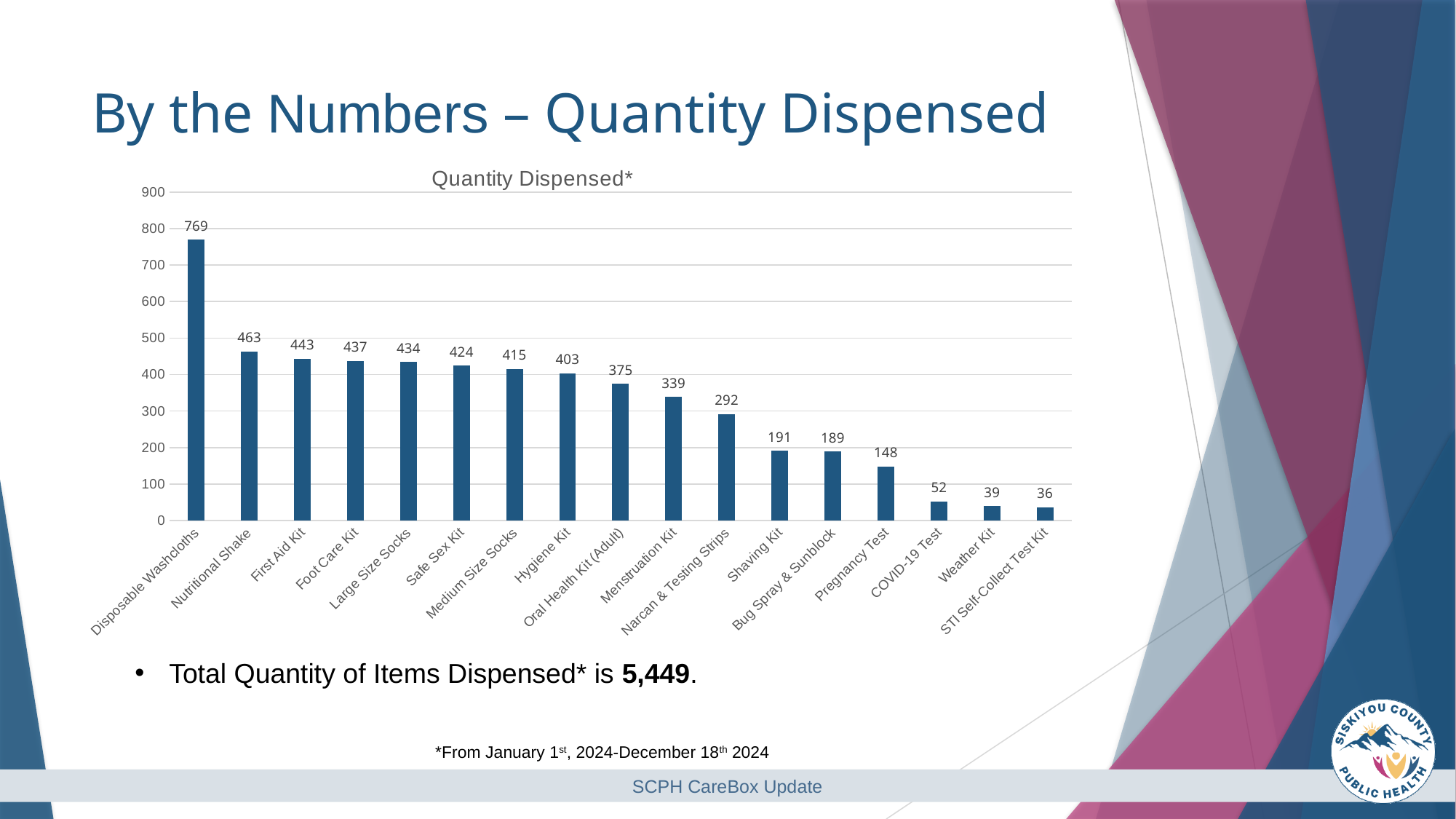
Which category has the lowest quantity dispensed? STI Self-Collect Test Kit What is the value for Pregnancy Test? 148 Do the values rise or fall from left to right along the x axis? Fall Which is larger, the value for Hygiene Kit or the value for Menstruation Kit? Hygiene Kit What is the difference between the values for COVID-19 Test and STI Self-Collect Test Kit? 16 What kind of chart is shown on the slide? Bar chart Which category has the highest quantity dispensed? Disposable Washcloths What is the value for Narcan & Testing Strips? 292 What is the value for Disposable Washcloths? 769 What is the title of the chart? Quantity Dispensed* What is the difference between the values for Disposable Washcloths and Nutritional Shake? 306 How many categories are shown on the chart? 17